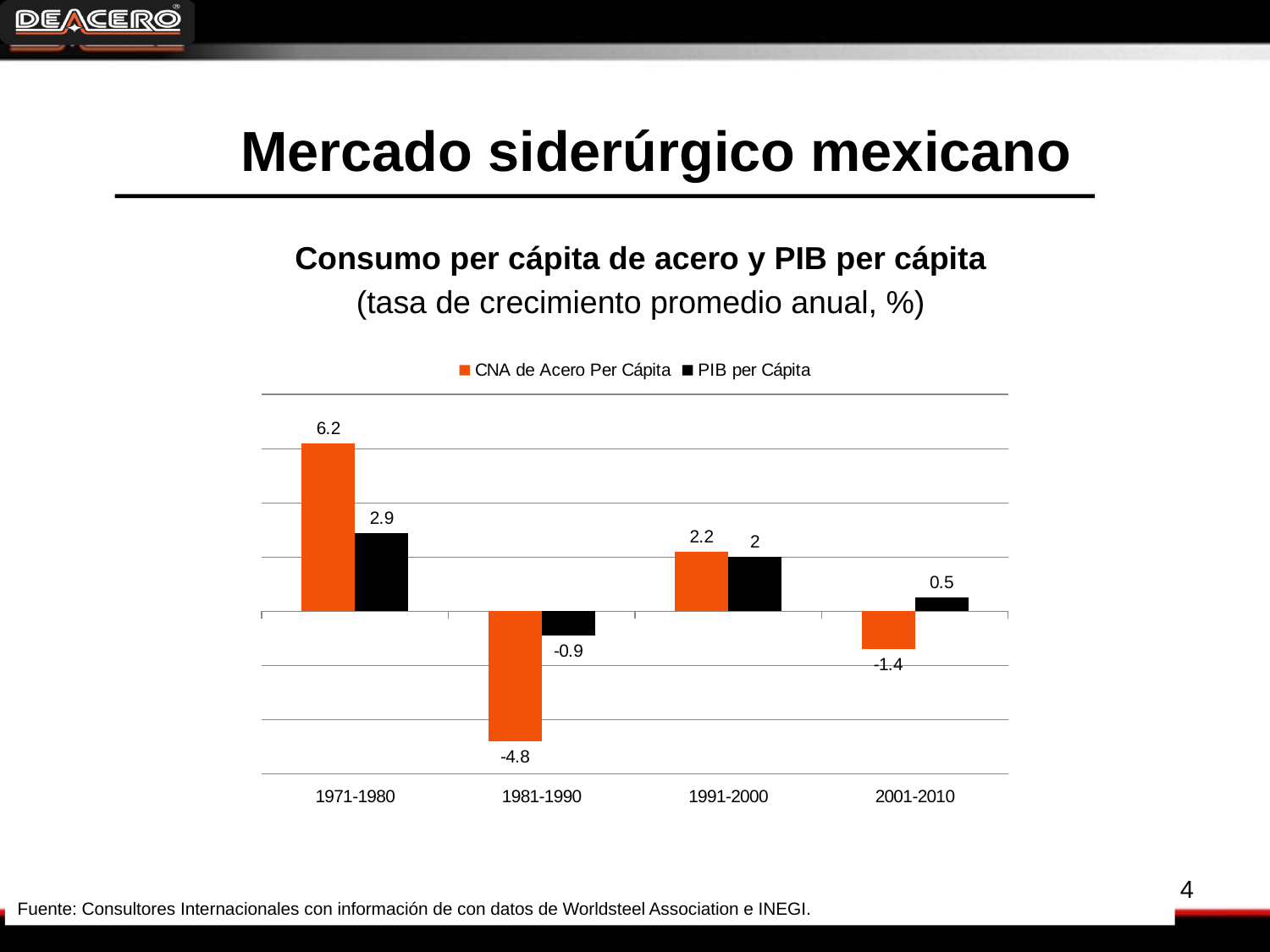
Which period has the highest value for CNA de Acero Per Cápita? 1971-1980 How many periods are shown on the x axis? 4 How many series does the legend list? 2 What is the value of PIB per Cápita for 1981-1990? -0.9 Which colour represents PIB per Cápita in the chart? Black What is the value of PIB per Cápita for 1991-2000? 2 What is the value of CNA de Acero Per Cápita for 1971-1980? 6.2 What is the difference between CNA de Acero Per Cápita and PIB per Cápita in 1971-1980? 3.3 What is the value of CNA de Acero Per Cápita for 2001-2010? -1.4 What kind of chart is shown on the slide? Bar chart Which period has the lowest value for PIB per Cápita? 1981-1990 In 2001-2010, which is larger: CNA de Acero Per Cápita or PIB per Cápita? PIB per Cápita